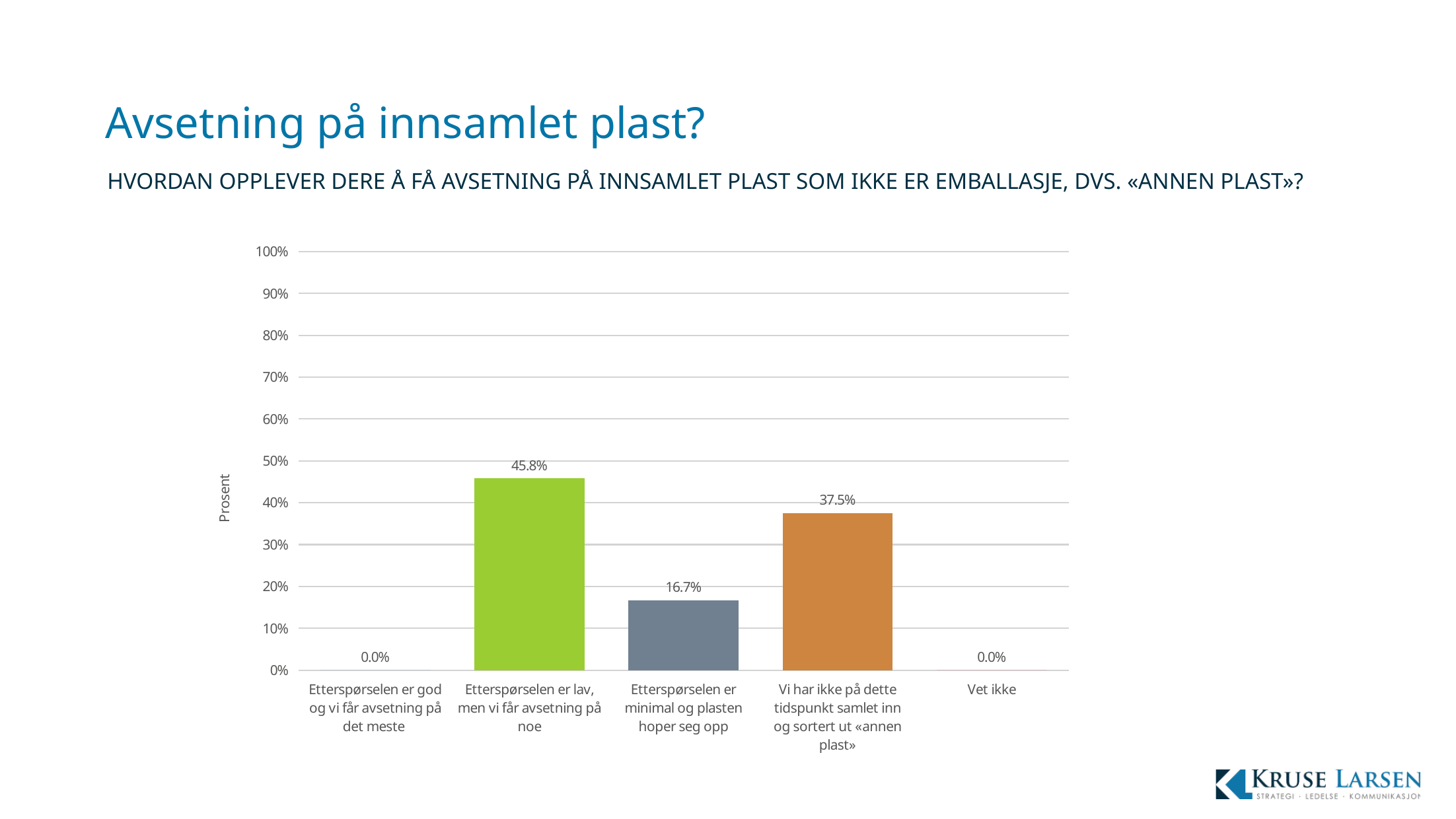
Is the value for "Etterspørselen er lav, men vi får avsetning på noe" greater or less than 40%? greater What is the value for "Etterspørselen er minimal og plasten hoper seg opp"? 16.7% What is the label of the y axis? Prosent What is the value for "Vet ikke"? 0.0% What is the difference between the values for "Etterspørselen er lav, men vi får avsetning på noe" and "Vi har ikke på dette tidspunkt samlet inn og sortert ut «annen plast»"? 8.3% What is the value for "Vi har ikke på dette tidspunkt samlet inn og sortert ut «annen plast»"? 37.5% Which category has the highest value? Etterspørselen er lav, men vi får avsetning på noe Which is larger: the value for "Etterspørselen er minimal og plasten hoper seg opp" or the value for "Vi har ikke på dette tidspunkt samlet inn og sortert ut «annen plast»"? Vi har ikke på dette tidspunkt samlet inn og sortert ut «annen plast» What is the value for "Etterspørselen er god og vi får avsetning på det meste"? 0.0% What kind of chart is shown on the slide? bar chart What is the value for "Etterspørselen er lav, men vi får avsetning på noe"? 45.8% How many categories are shown on the x axis? 5